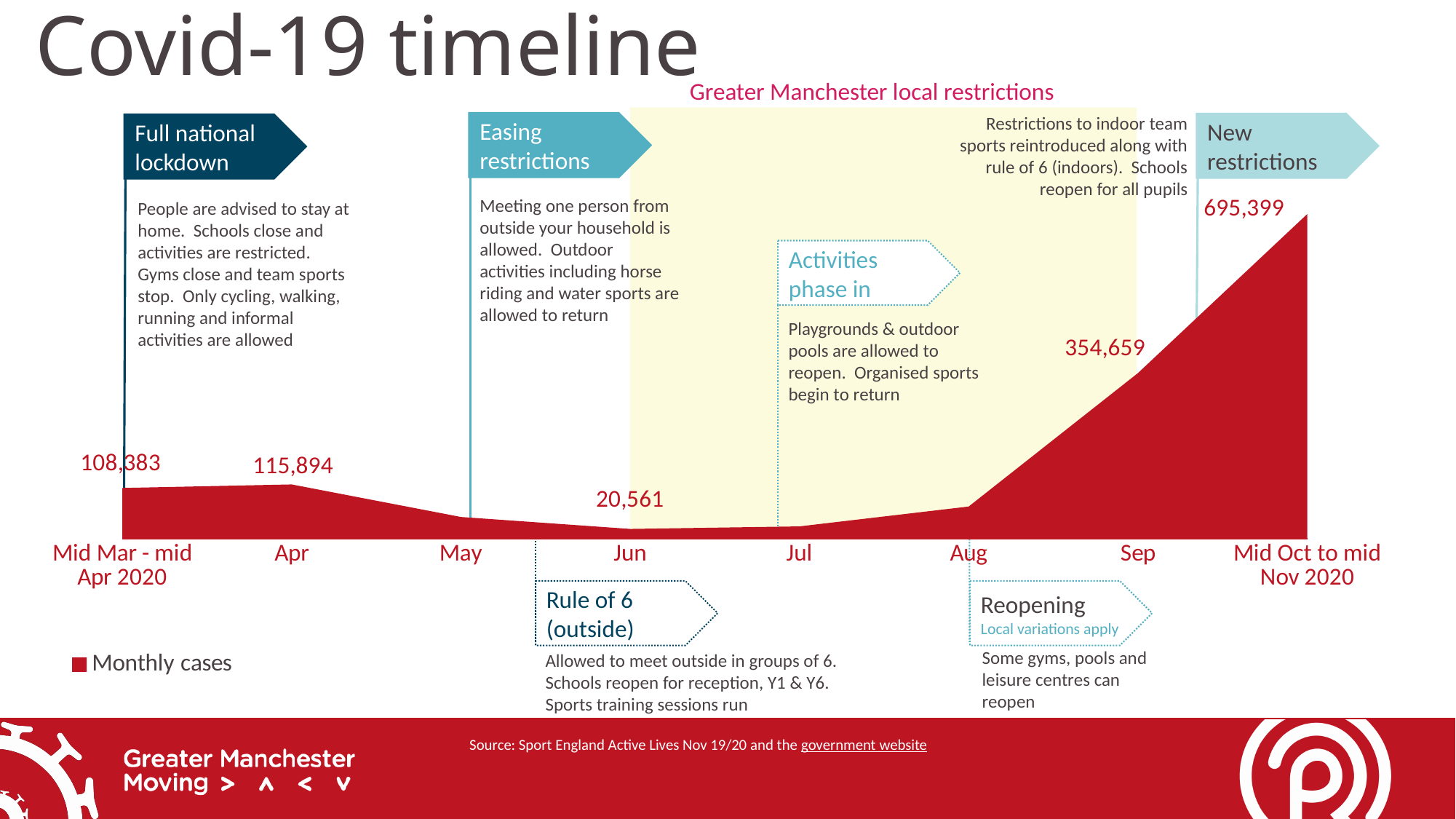
Which has more Monthly cases, Apr or Sep? Sep What is the value of Monthly cases for Apr? 115,894 How many series does the chart legend list? 1 How many time periods are shown on the x axis of the chart? 8 What is the value of Monthly cases for Mid Oct to mid Nov 2020? 695,399 What is the value of Monthly cases for Sep? 354,659 What is the difference in Monthly cases between Apr and Mid Mar - mid Apr 2020? 7,511 What is the difference in Monthly cases between Mid Oct to mid Nov 2020 and Sep? 340,740 What is the value of Monthly cases for Mid Mar - mid Apr 2020? 108,383 What is the value of Monthly cases for Jun? 20,561 What kind of chart is used to show Monthly cases? Area chart Which period has the highest number of Monthly cases? Mid Oct to mid Nov 2020